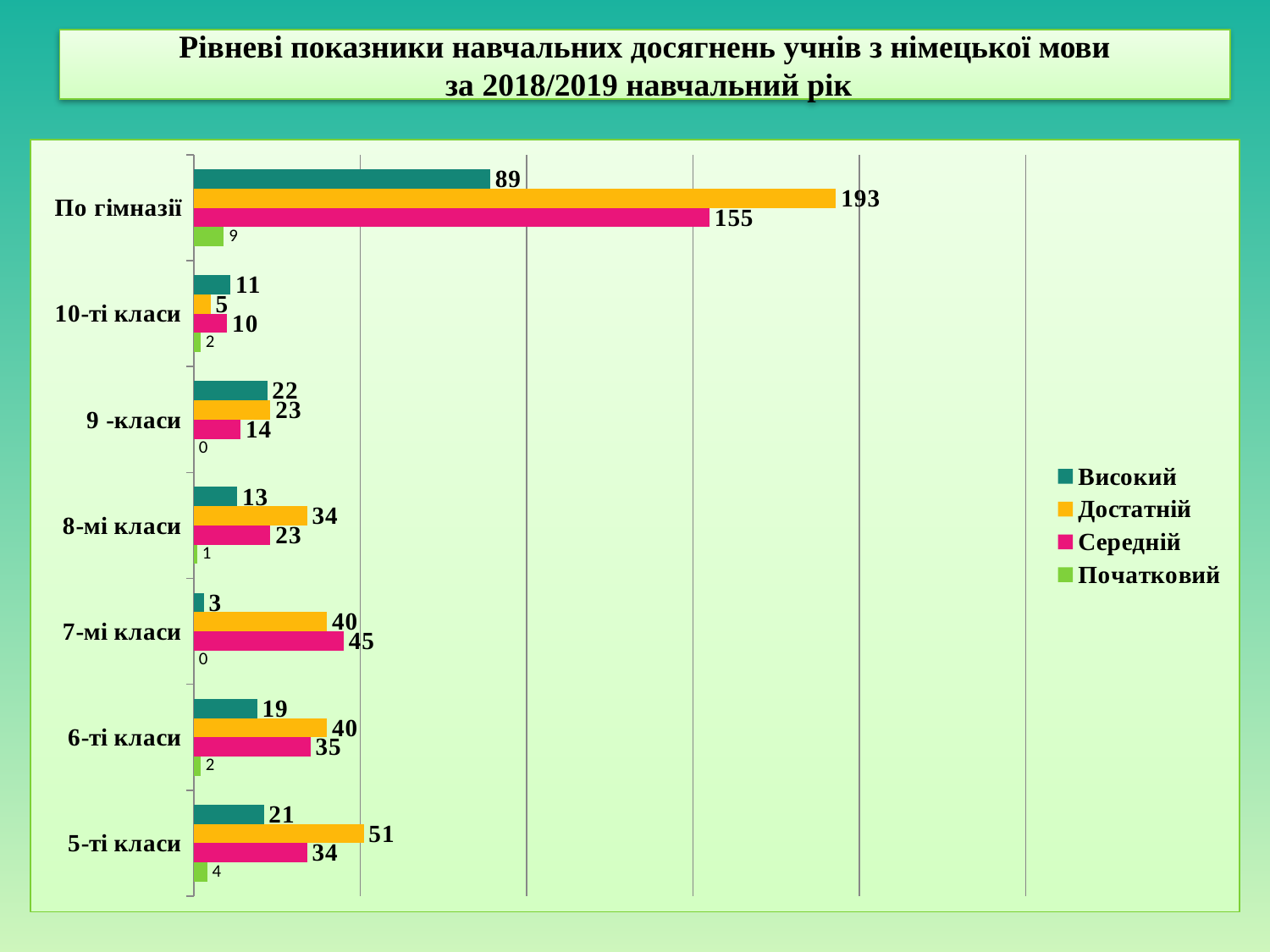
Which is larger for 6-ті класи: Достатній or Середній? Достатній Among the class categories (excluding По гімназії), which has the lowest value for Високий? 7-мі класи What is the total of the four series values for 5-ті класи? 110 What is the value for Достатній for По гімназії? 193 What kind of chart is shown on the slide? Bar chart What is the value for Середній for 7-мі класи? 45 What is the value for Високий for 5-ті класи? 21 How many series does the legend list? 4 Which category has the highest value for Достатній? По гімназії What is the value for Початковий for 9 -класи? 0 What is the difference between the Достатній and Середній values for По гімназії? 38 How many categories are shown on the vertical axis? 7